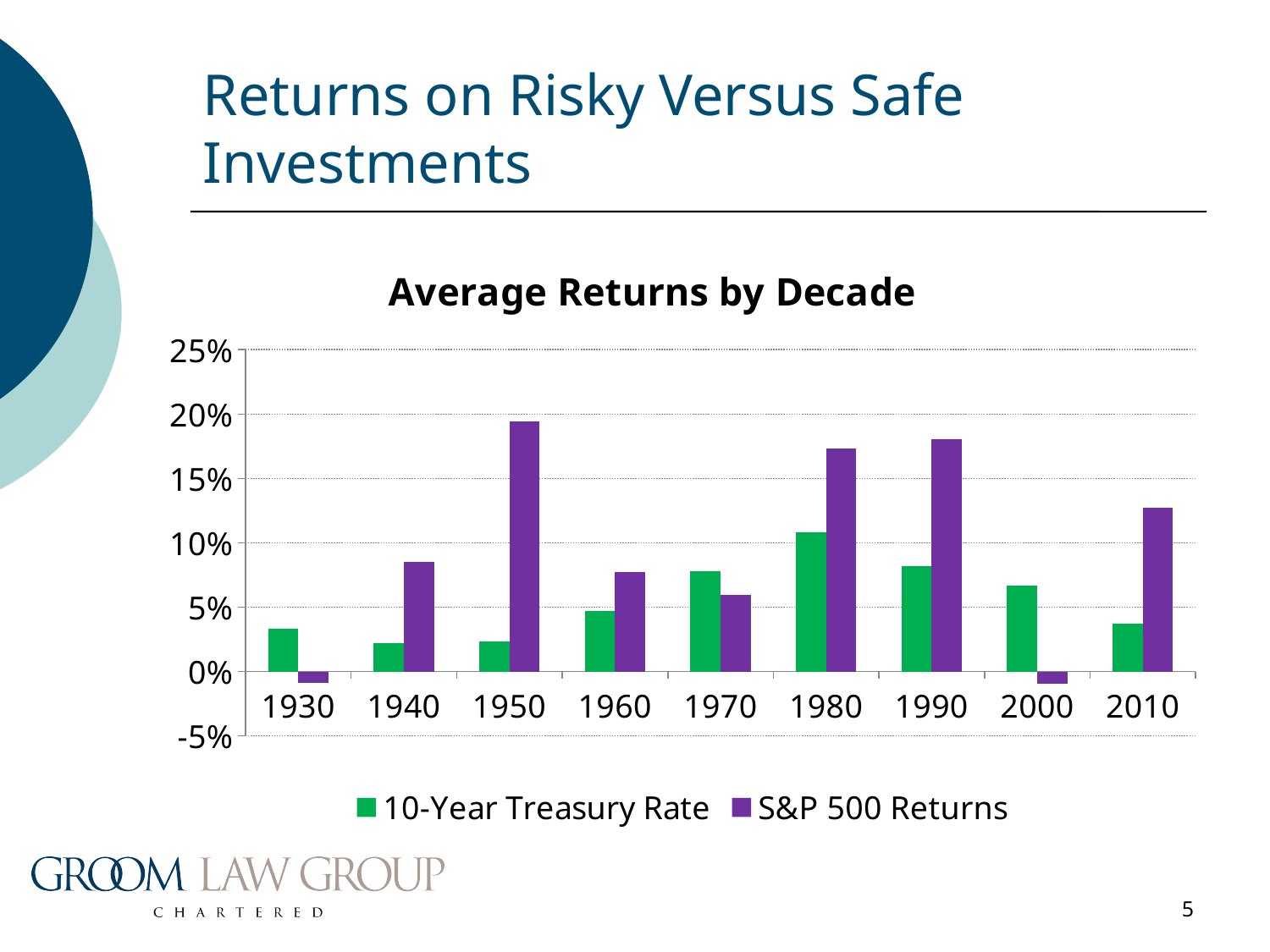
Which series is shown in purple? S&P 500 Returns What kind of chart is shown on the slide? bar chart In 2010, which is larger: the 10-Year Treasury Rate or the S&P 500 Returns? S&P 500 Returns In 1970, which is larger: the 10-Year Treasury Rate or the S&P 500 Returns? 10-Year Treasury Rate In which decade is the 10-Year Treasury Rate highest? 1980 Is the 10-Year Treasury Rate for 1980 greater or less than 10%? greater In which decade is the S&P 500 Returns value highest? 1950 Is the S&P 500 Returns value for 1950 greater or less than 15%? greater How many decades are shown on the x axis? 9 What is the title of the chart? Average Returns by Decade Is the S&P 500 Returns value for 2000 greater or less than 0%? less How many series does the legend list? 2